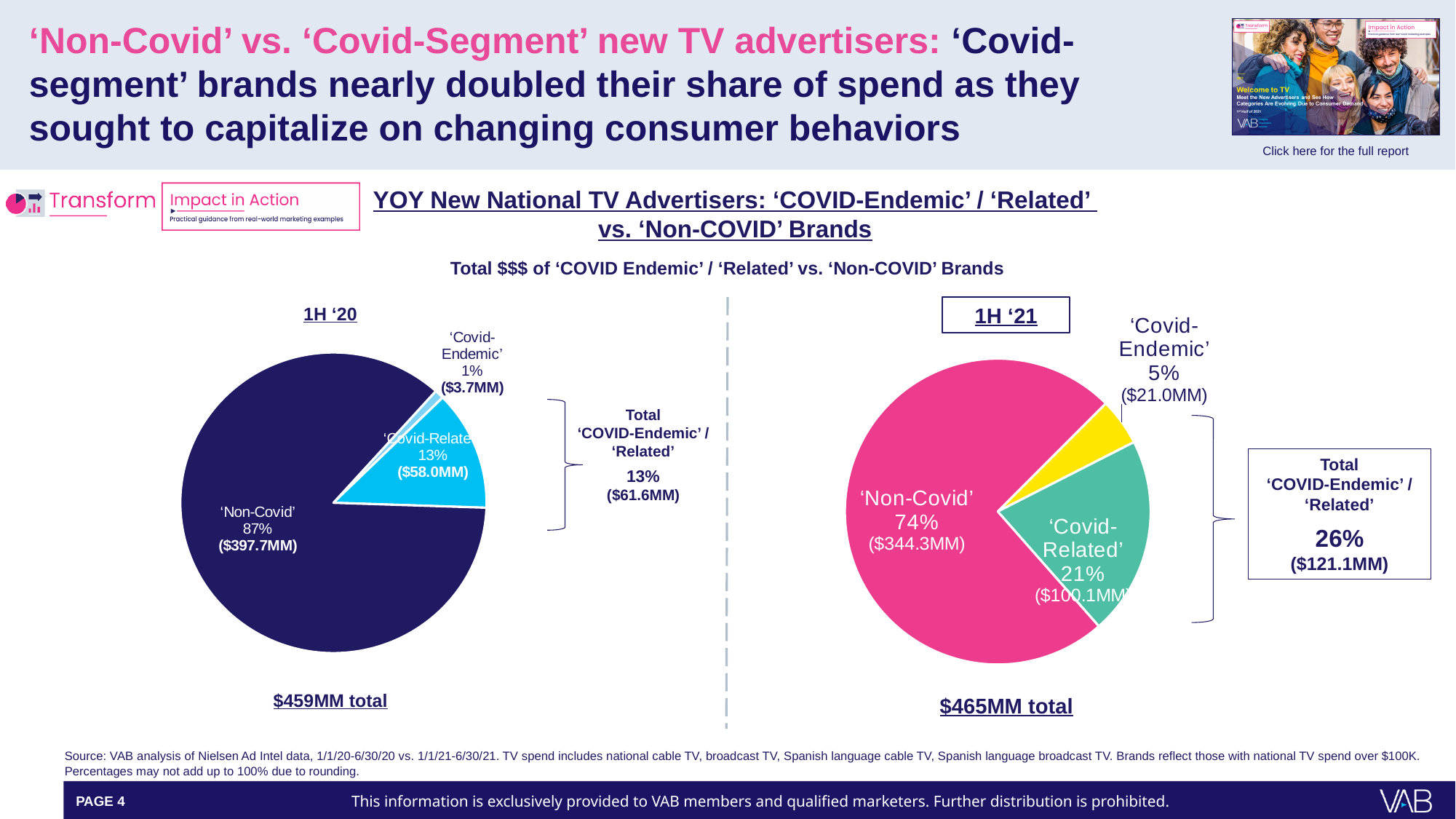
In the 1H '20 pie chart, which slice is the largest? 'Non-Covid' How many slices does the 1H '21 pie chart have? 3 In the 1H '21 pie chart, which slice is the smallest? 'Covid-Endemic' In the 1H '20 pie chart, what share of spend is 'Non-Covid'? 87% In the 1H '20 pie chart, what is the dollar value for 'Covid-Endemic'? $3.7MM What is the total spend shown for the 1H '21 pie chart? $465MM In the 1H '21 pie chart, what is the dollar value for 'Non-Covid'? $344.3MM What type of charts are shown on the slide? Pie charts What is the difference in the 'Covid-Endemic' share between the 1H '21 and 1H '20 pie charts? 4 percentage points In the 1H '21 pie chart, what share of spend is 'Covid-Related'? 21% In the 1H '20 pie chart, what is the dollar value for 'Covid-Related'? $58.0MM Which is larger: the 'Covid-Related' value in 1H '21 or in 1H '20? 1H '21